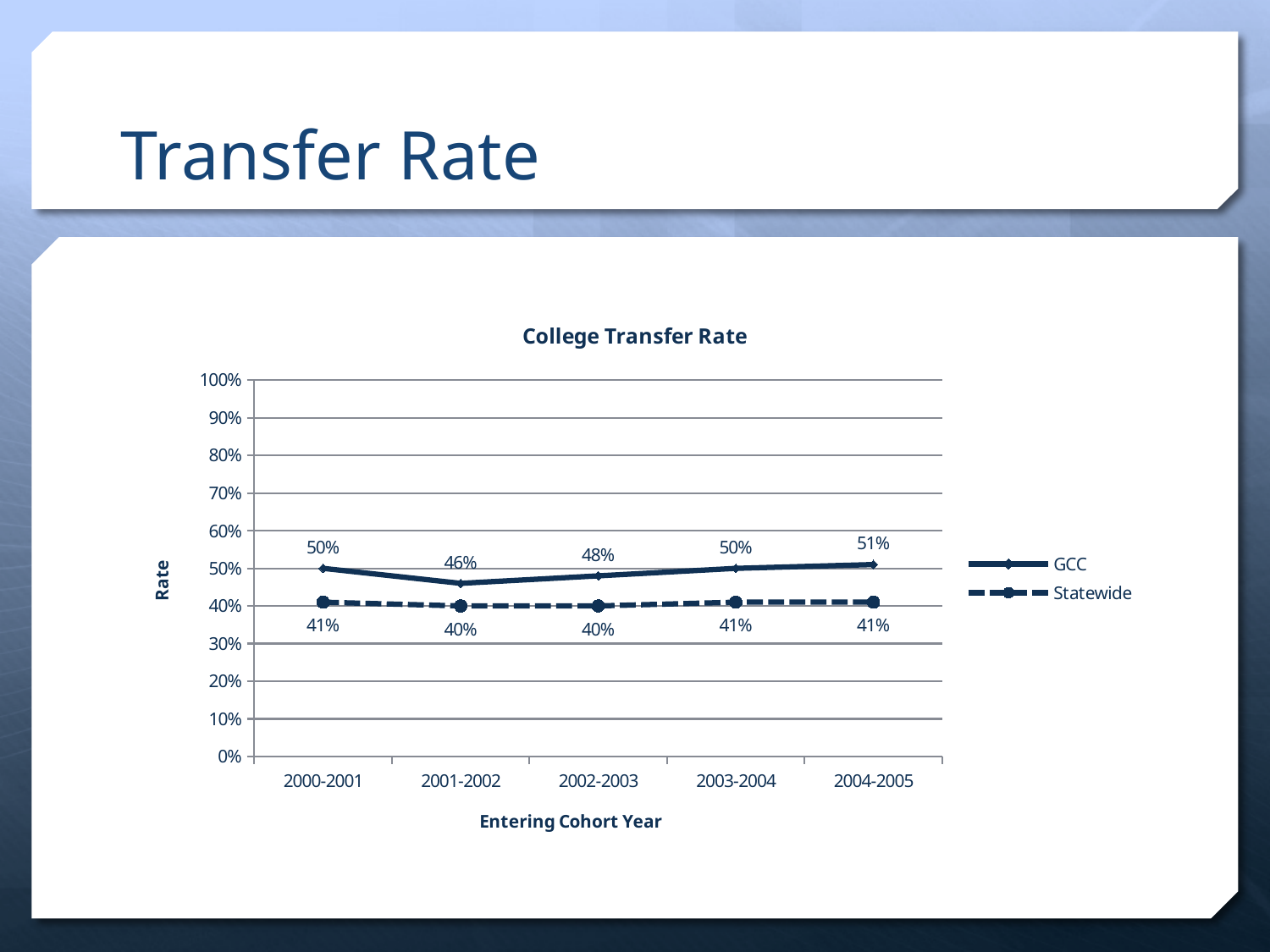
How many series does the legend list? 2 What is the GCC transfer rate for the 2001-2002 entering cohort? 46% Which entering cohort year has the lowest GCC transfer rate? 2001-2002 What is the difference between the GCC transfer rates for 2000-2001 and 2001-2002? 4% For the 2002-2003 cohort, which series has the higher transfer rate, GCC or Statewide? GCC What is the difference between the GCC and Statewide transfer rates for the 2004-2005 cohort? 10% Which entering cohort year has the highest GCC transfer rate? 2004-2005 What is the GCC transfer rate for the 2004-2005 entering cohort? 51% How many entering cohort years are shown on the x axis? 5 What kind of chart is shown on the slide? Line chart What is the title of the chart? College Transfer Rate What is the Statewide transfer rate for the 2003-2004 entering cohort? 41%